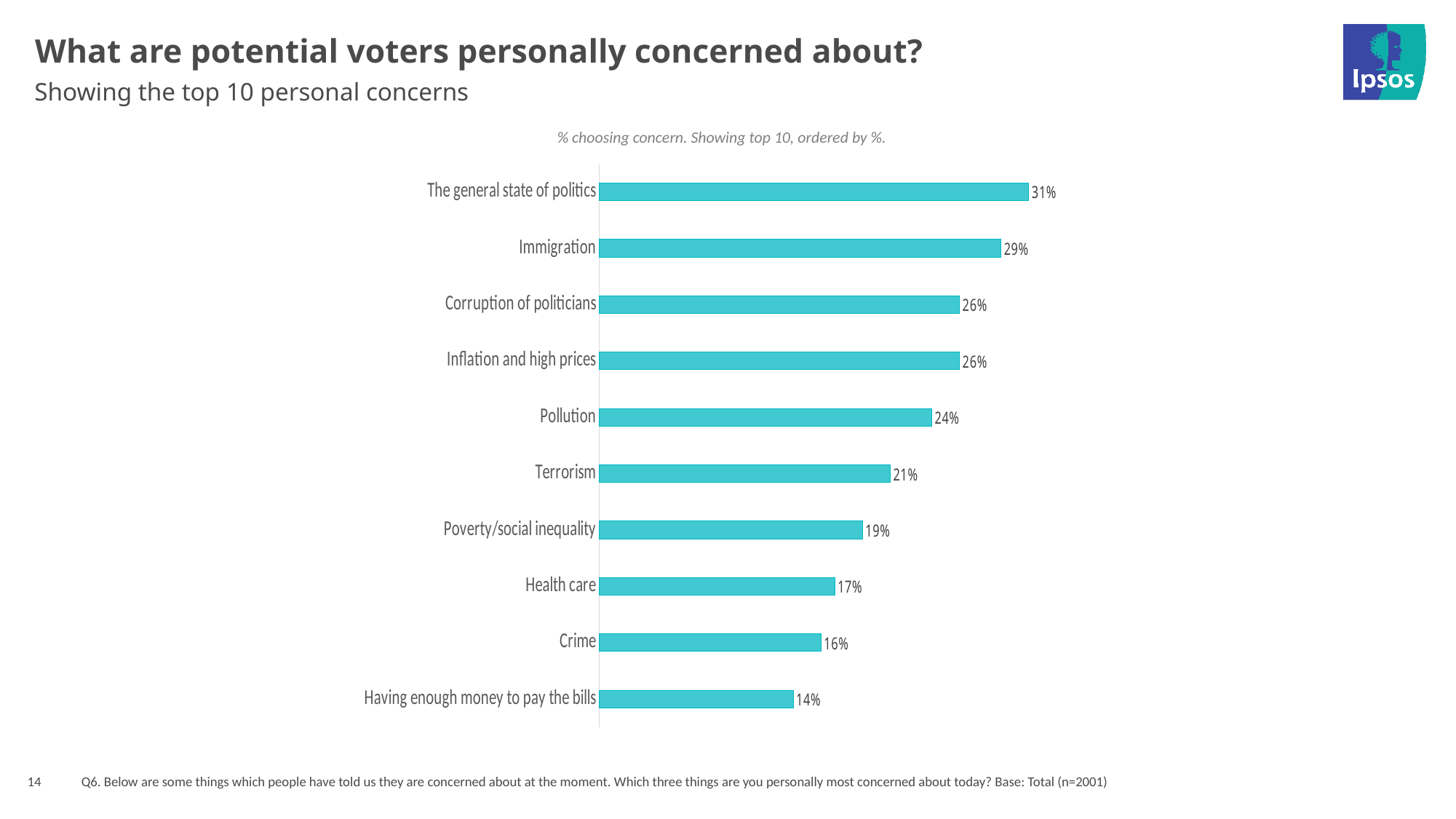
What is the difference in percentage points between Terrorism and Crime? 5 Which has a higher value, Health care or Poverty/social inequality? Poverty/social inequality What type of chart is shown on the slide? Bar chart Which concern has the lowest percentage? Having enough money to pay the bills Which has a higher value, Pollution or Terrorism? Pollution What is the value shown for Pollution? 24% What is the value shown for Corruption of politicians? 26% How many concerns are shown in the chart? 10 What percentage is shown for Having enough money to pay the bills? 14% What percentage of potential voters chose Immigration as a personal concern? 29% What is the difference in percentage points between The general state of politics and Immigration? 2 Which concern has the highest percentage? The general state of politics